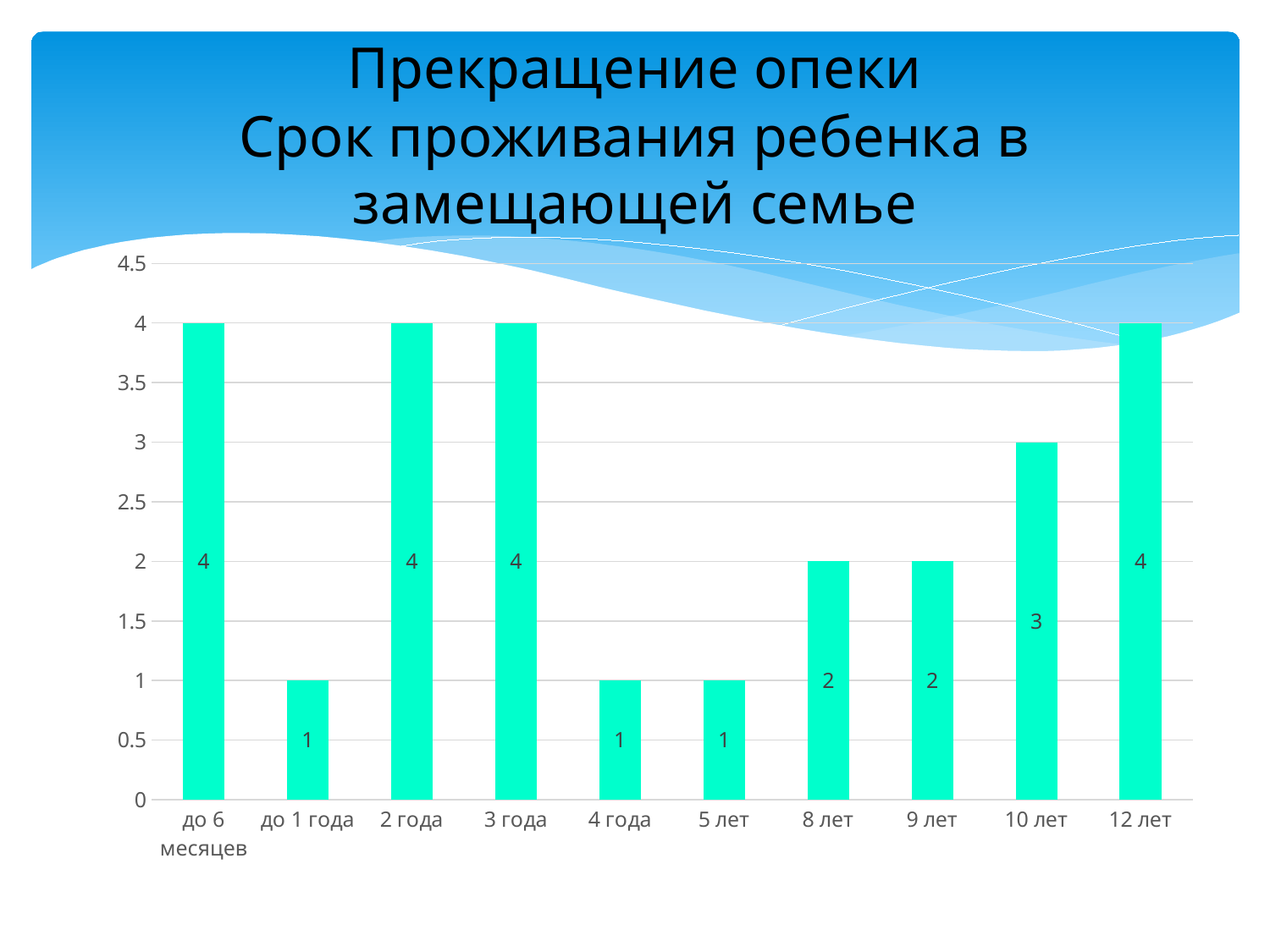
What is the value for "12 лет"? 4 Which is larger, the value for "10 лет" or the value for "5 лет"? 10 лет What is the value for "до 1 года"? 1 What is the value for "10 лет"? 3 Which is larger, the value for "8 лет" or the value for "2 года"? 2 года What kind of chart is shown on the slide? Bar chart What is the difference between the values for "3 года" and "4 года"? 3 What is the value for "до 6 месяцев"? 4 What is the highest value shown on the vertical axis? 4.5 What is the value for "8 лет"? 2 How many categories are shown on the x axis? 10 What is the difference between the values for "10 лет" and "9 лет"? 1